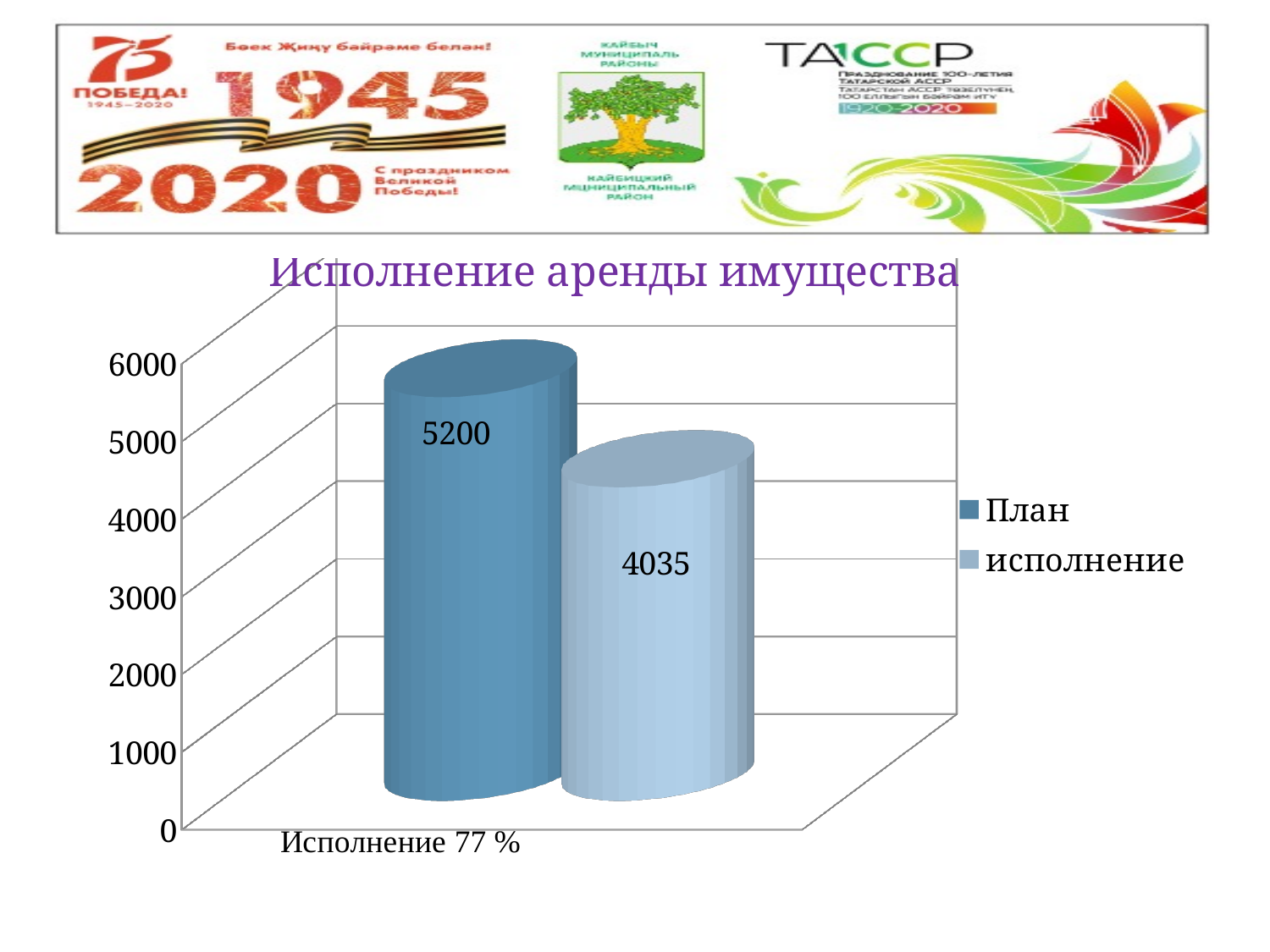
What is the value of the План series? 5200 Is the value for План greater or less than 5000? greater What is the difference between the План value and the исполнение value? 1165 What is the title of the chart? Исполнение аренды имущества What is the category label shown on the x axis? Исполнение 77 % How many categories are shown on the x axis? 1 Which series has the lowest value? исполнение What kind of chart is shown on the slide? bar chart Is the value for исполнение greater or less than 5000? less How many series does the legend list? 2 What is the value of the исполнение series? 4035 Which series has the higher value, План or исполнение? План